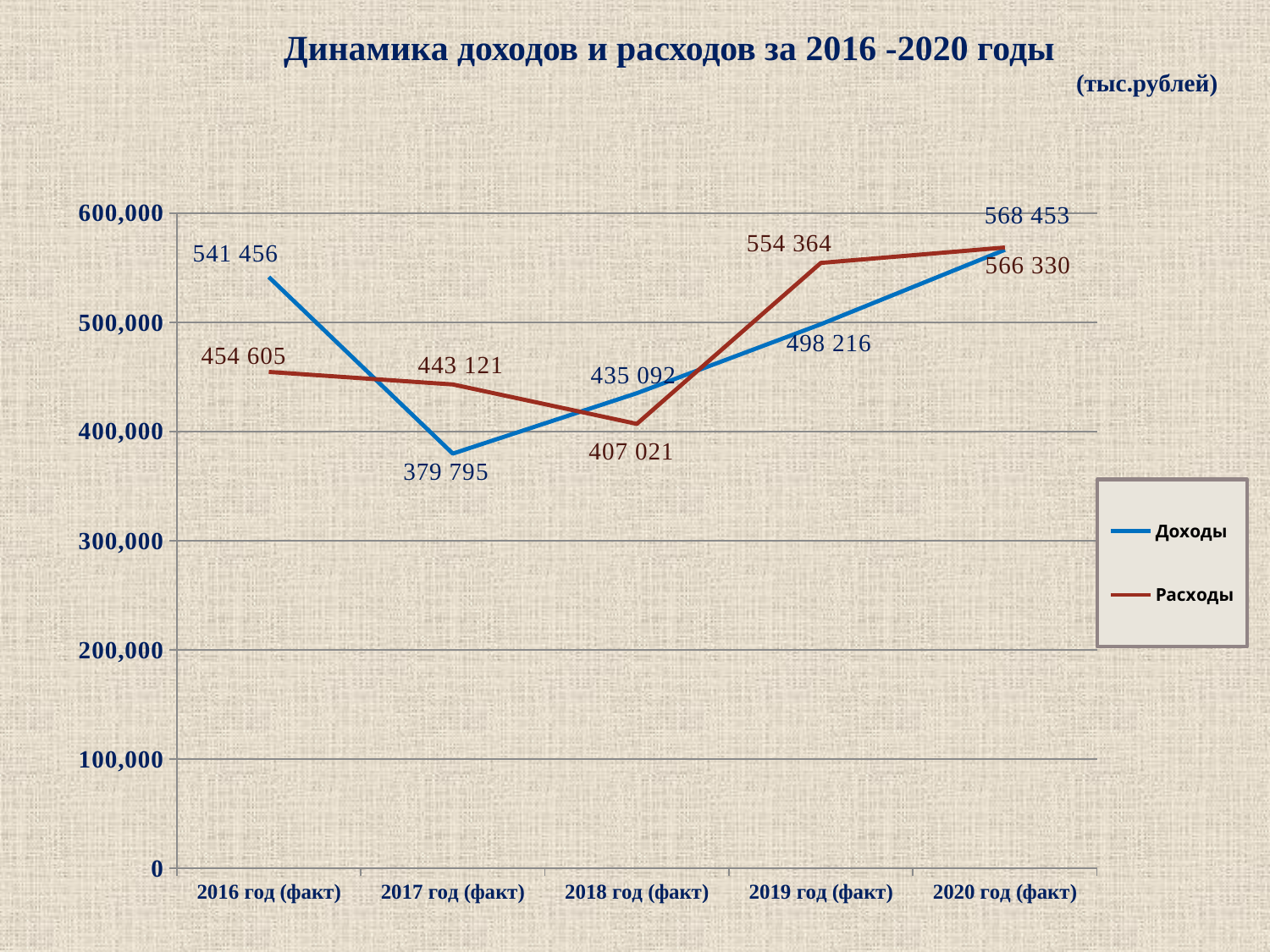
Does Расходы rise or fall from 2016 год (факт) to 2018 год (факт)? Fall In which year is Расходы the lowest? 2018 год (факт) What is the value of Расходы for 2019 год (факт)? 554 364 What is the difference between Доходы and Расходы in 2016 год (факт)? 86 851 What is the value of Доходы for 2020 год (факт)? 568 453 Which is larger in 2018 год (факт), Доходы or Расходы? Доходы What kind of chart is shown on the slide? Line chart How many years are shown on the x axis? 5 In which year is Доходы the highest? 2020 год (факт) How many series does the legend list? 2 What is the value of Доходы for 2017 год (факт)? 379 795 In which year is Доходы the lowest? 2017 год (факт)